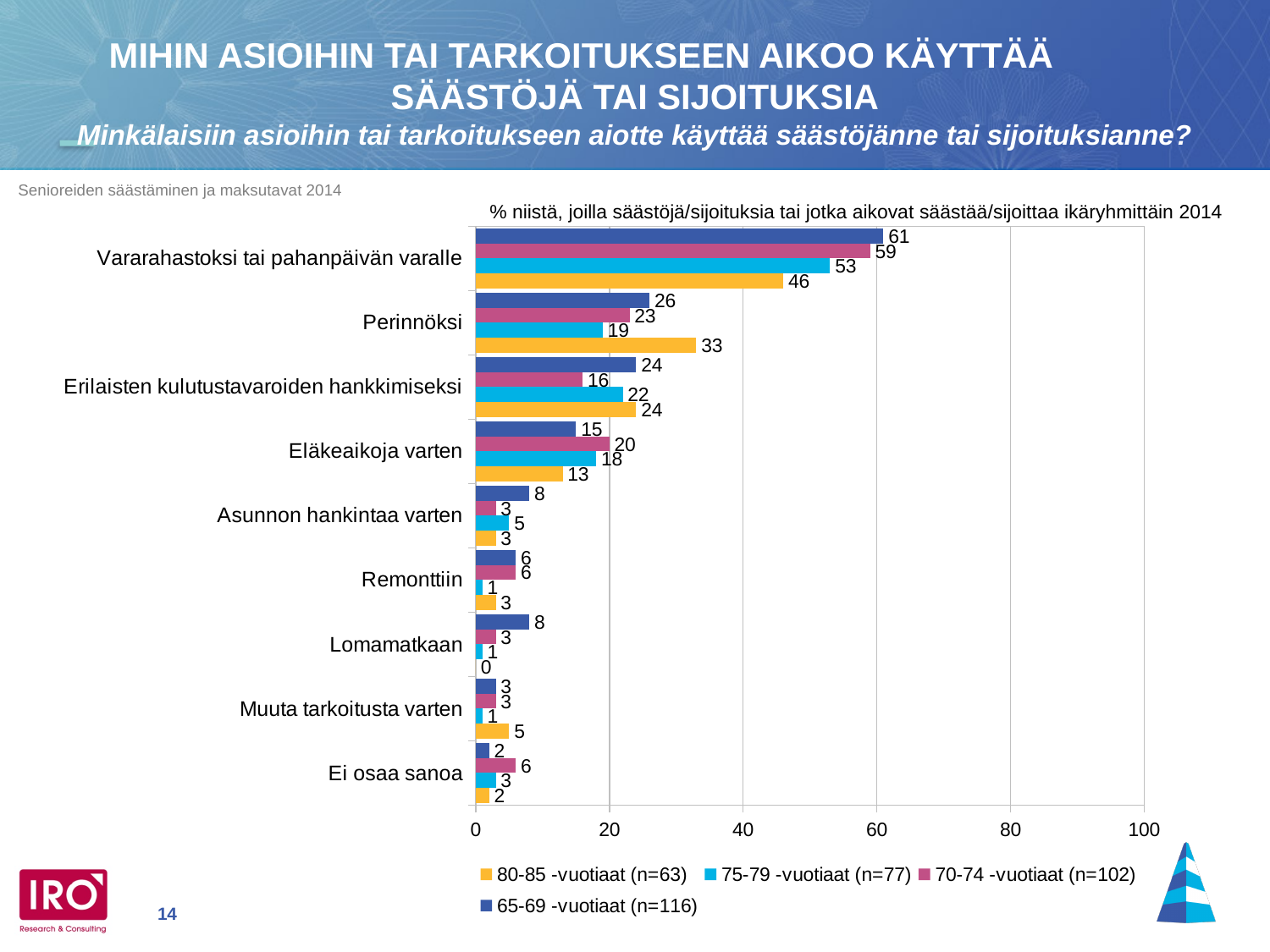
Which category has the lowest value for 80-85 -vuotiaat (n=63)? Lomamatkaan Which category has the highest value for 65-69 -vuotiaat (n=116)? Vararahastoksi tai pahanpäivän varalle How many series does the legend list? 4 What kind of chart is shown on the slide? Bar chart What is the value for 75-79 -vuotiaat (n=77) in the category Eläkeaikoja varten? 18 What is the difference between the 65-69 -vuotiaat (n=116) and 80-85 -vuotiaat (n=63) values for Vararahastoksi tai pahanpäivän varalle? 15 How many categories are shown on the chart? 9 What is the value for 65-69 -vuotiaat (n=116) in the category Vararahastoksi tai pahanpäivän varalle? 61 What is the value for 70-74 -vuotiaat (n=102) in the category Ei osaa sanoa? 6 Is the value for 70-74 -vuotiaat (n=102) in Vararahastoksi tai pahanpäivän varalle greater or less than 40? greater What is the value for 80-85 -vuotiaat (n=63) in the category Perinnöksi? 33 In the category Perinnöksi, which is larger: the value for 80-85 -vuotiaat (n=63) or for 65-69 -vuotiaat (n=116)? 80-85 -vuotiaat (n=63)